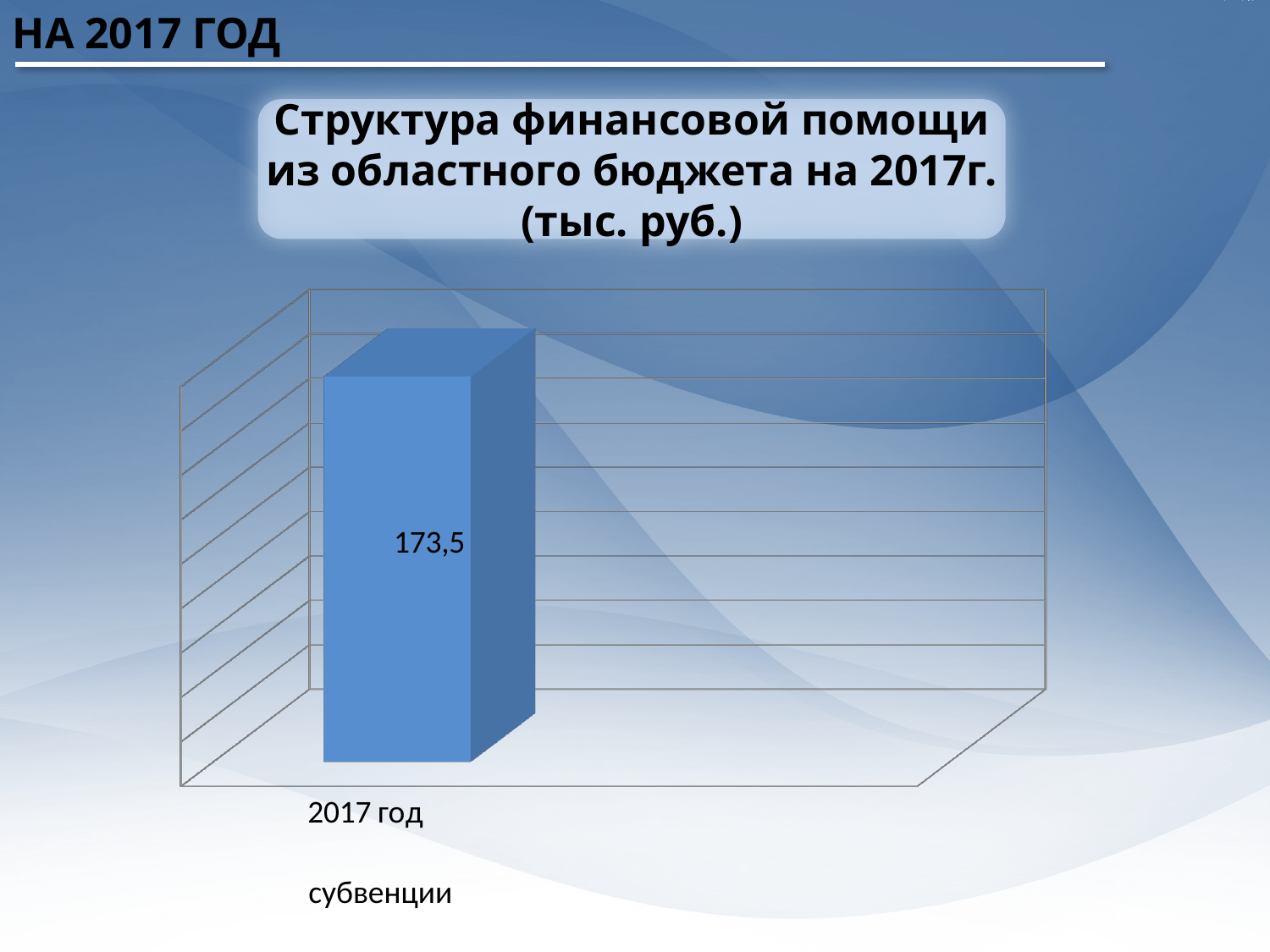
What category label appears on the x axis of the chart? 2017 год What is the value shown for субвенции in 2017 год? 173,5 How many bars are plotted in the chart? 1 What is the name of the series shown in the legend? субвенции In what units are the chart values given, according to the chart title? тыс. руб. How many series does the legend list? 1 What kind of chart is shown on the slide? bar chart